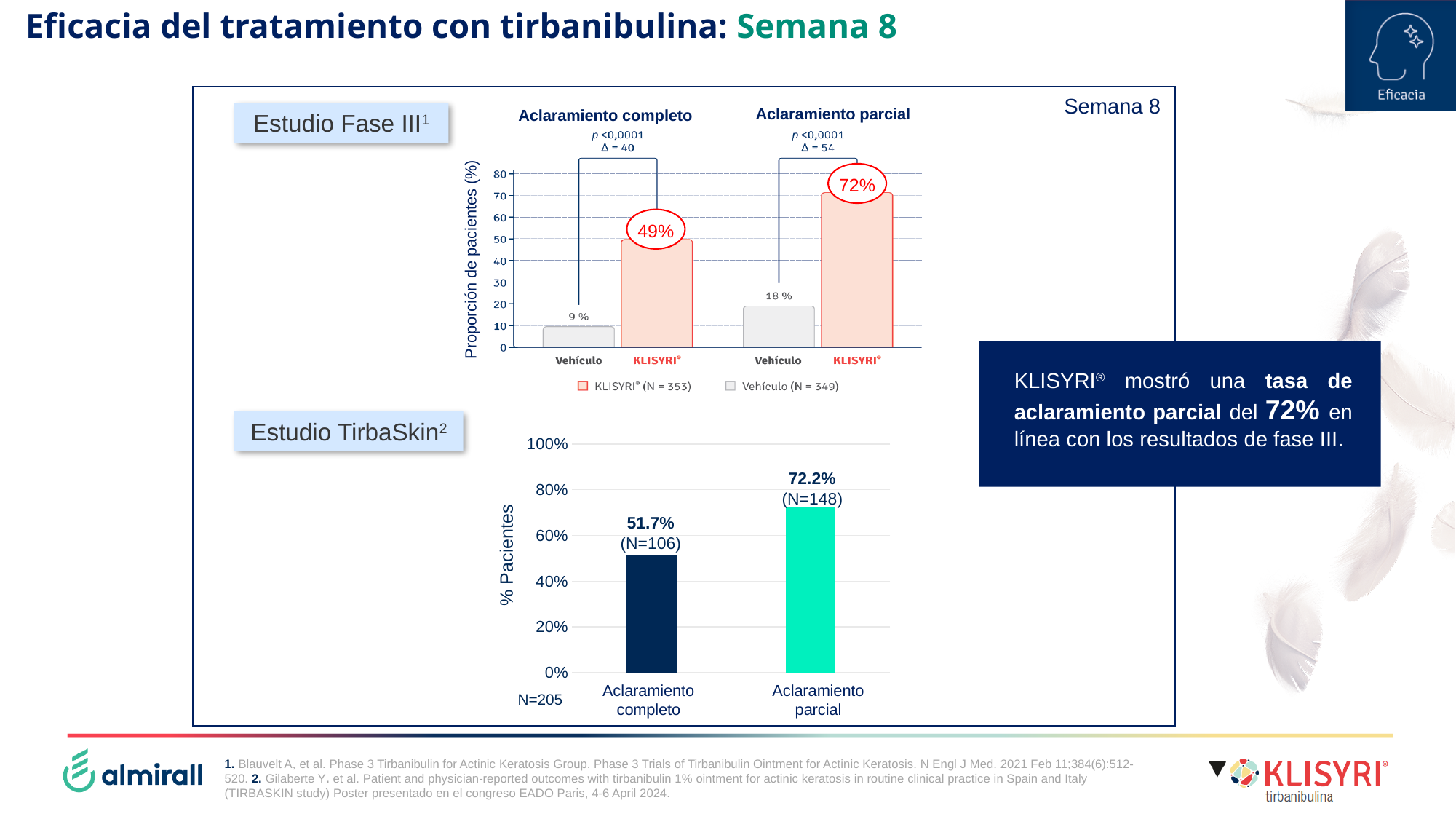
In the Estudio Fase III chart, what is the value for Vehículo under Aclaramiento completo? 9 % In the Estudio Fase III chart, what is the difference between KLISYRI and Vehículo for Aclaramiento parcial? 54 In the Estudio Fase III chart, what N is shown in the legend for Vehículo? N = 349 In the Estudio TirbaSkin chart, what is the value for Aclaramiento parcial? 72.2% In the Estudio TirbaSkin chart, what is the value for Aclaramiento completo? 51.7% In the Estudio Fase III chart, what is the value for KLISYRI under Aclaramiento completo? 49% In the Estudio Fase III chart, what is the value for Vehículo under Aclaramiento parcial? 18 % In the Estudio TirbaSkin chart, how many categories are plotted? 2 In the Estudio Fase III chart, how many series does the legend list? 2 In the Estudio Fase III chart, which bar is the highest? KLISYRI, Aclaramiento parcial (72%) In the Estudio TirbaSkin chart, which category has the lower value? Aclaramiento completo What kind of chart is the Estudio TirbaSkin chart? Bar chart